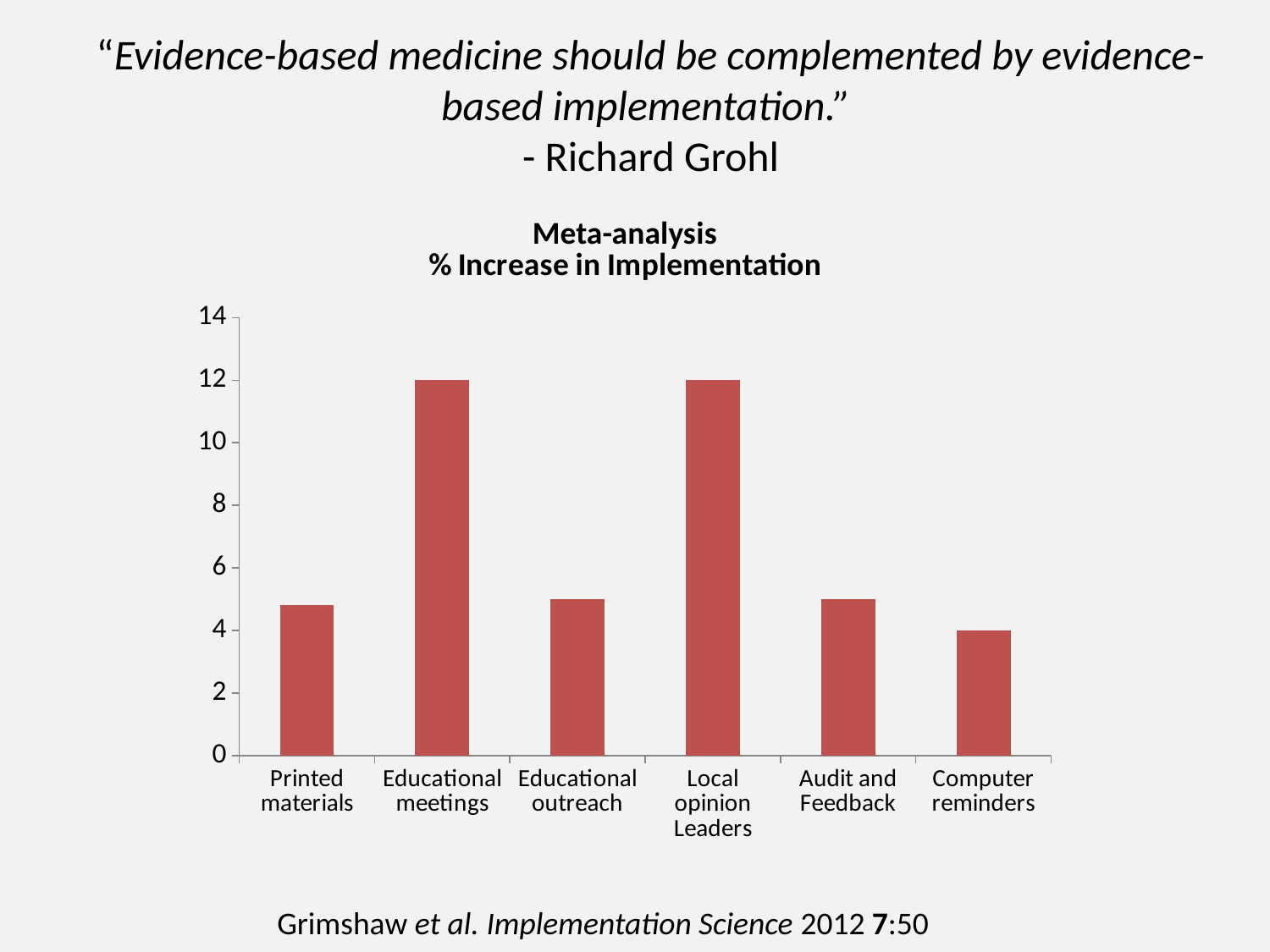
What is the value for Educational meetings? 12 Which is larger, the value for Educational meetings or the value for Educational outreach? Educational meetings Which category has the lowest value? Computer reminders Is the value for Printed materials greater or less than 6? less How many categories are shown on the x axis of the chart? 6 What type of chart is shown on the slide? Bar chart What is the value for Computer reminders? 4 Is the value for Audit and Feedback greater or less than 4? greater What is the highest value shown on the y axis? 14 What is the value for Local opinion Leaders? 12 What is the difference between the values for Educational meetings and Computer reminders? 8 What is the title of the chart? Meta-analysis % Increase in Implementation